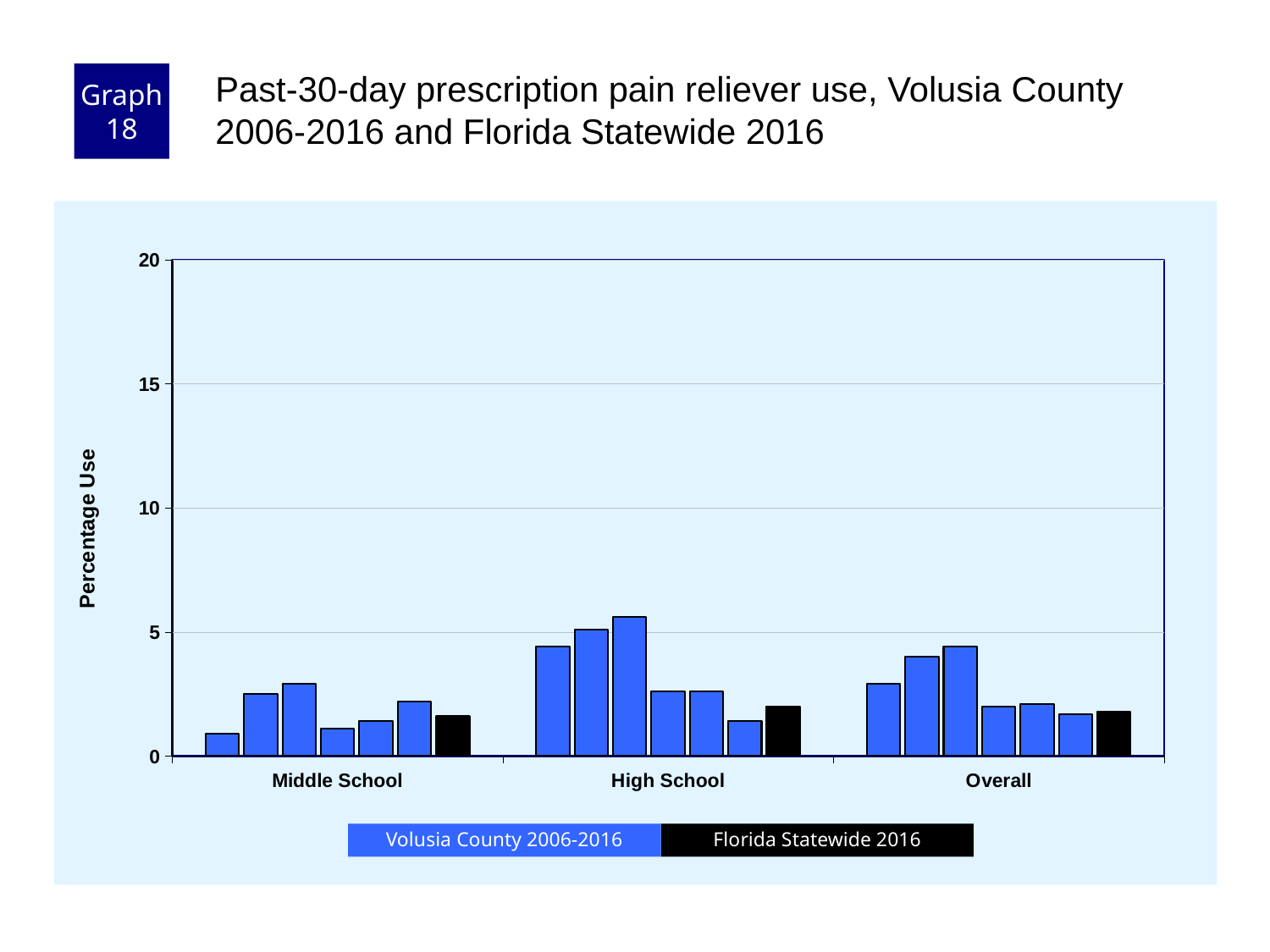
How many series does the legend list? 2 How many categories are shown on the x axis? 3 Is the Florida Statewide 2016 value for Middle School greater or less than 5? less What is the label on the y axis? Percentage Use Which colour represents Florida Statewide 2016 in the legend? black Which is larger: the tallest Volusia County 2006-2016 bar for High School or the tallest Volusia County 2006-2016 bar for Middle School? High School What kind of chart is shown on the slide? bar chart Which category contains the tallest bar in the chart? High School Is the tallest bar in the Overall category greater or less than 5? less Is the tallest Volusia County 2006-2016 bar for High School greater or less than 5? greater